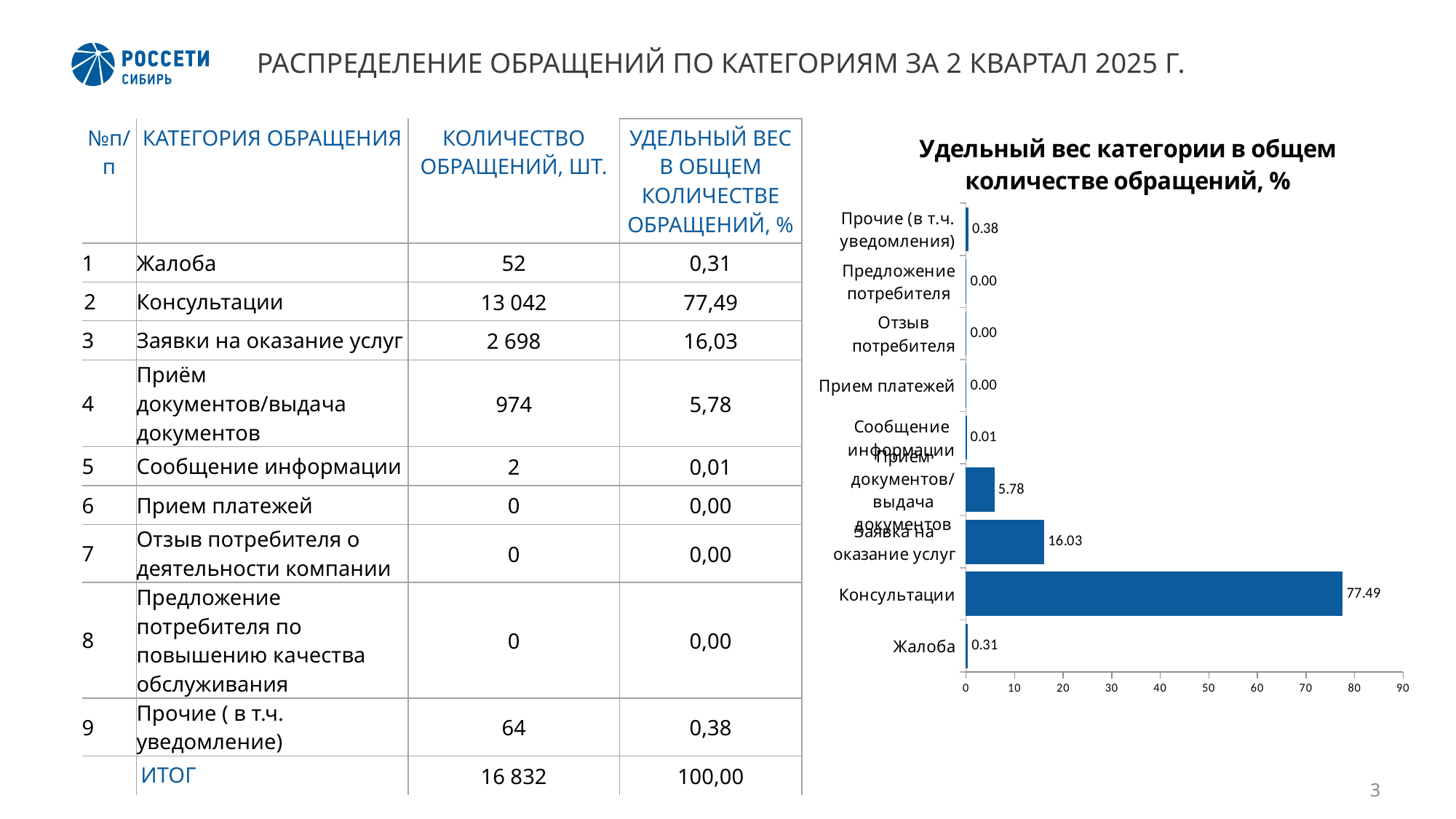
Is the value for Консультации greater or less than 70? greater What is the value for Консультации in the chart? 77.49 What is the value for Заявка на оказание услуг in the chart? 16.03 What is the difference between the values for Консультации and Заявка на оказание услуг? 61.46 Which is larger: the value for Заявка на оказание услуг or the value for Приём документов/выдача документов? Заявка на оказание услуг What kind of chart is shown on the slide? bar chart What is the value for Прочие (в т.ч. уведомления) in the chart? 0.38 Which category has the highest value in the chart? Консультации What is the title of the chart? Удельный вес категории в общем количестве обращений, % What is the maximum value shown on the chart's horizontal axis? 90 What is the value for Жалоба in the chart? 0.31 How many categories are shown in the chart? 9